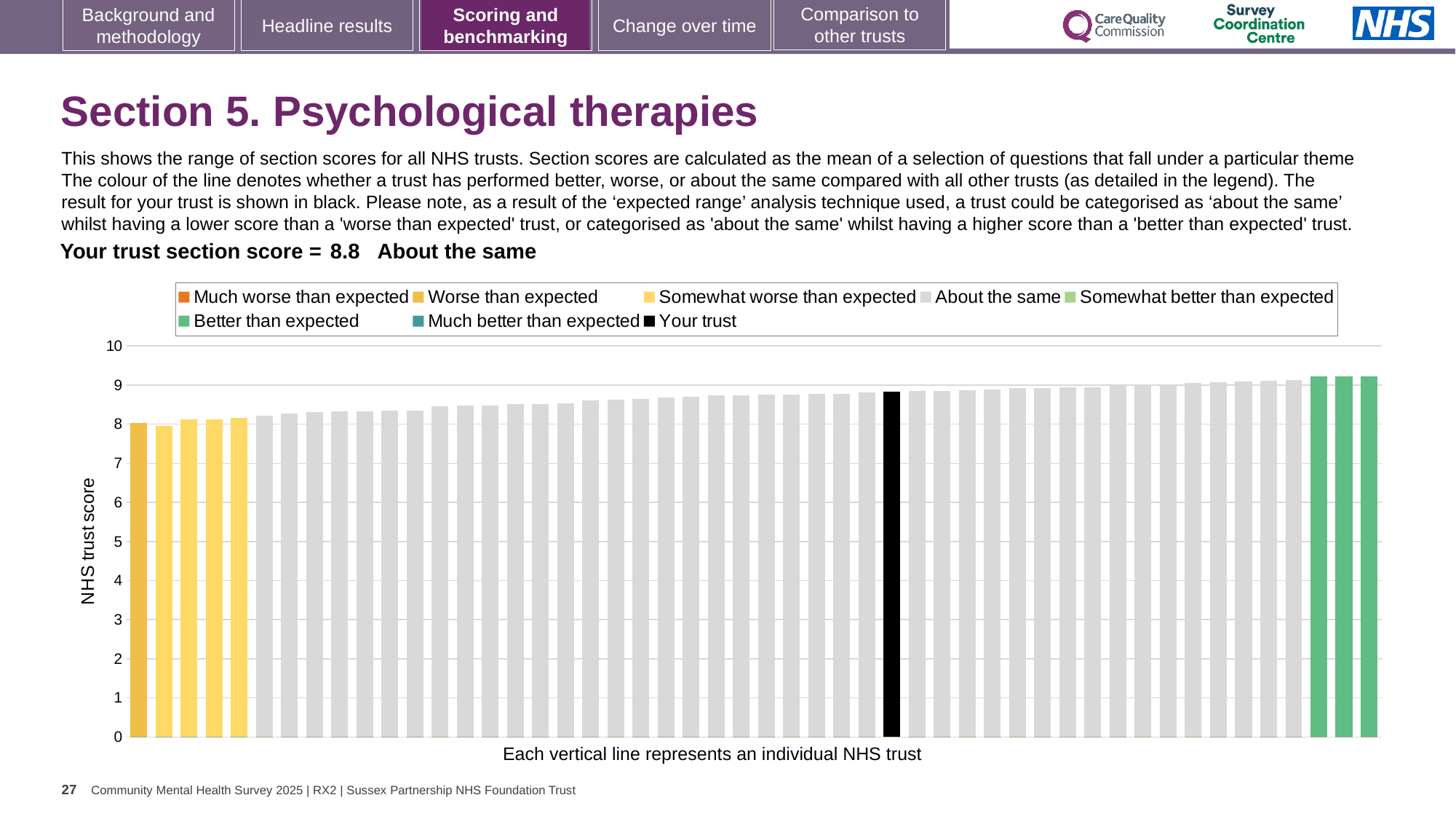
What kind of chart is shown on the slide? bar chart Which category is your trust placed in for this section? About the same How many yellow/orange bars (worse or somewhat worse than expected) are on the chart? 5 What does the black bar on the chart represent? Your trust How many green bars (better than expected) are on the chart? 3 Do the bar values rise or fall moving from left to right along the x axis? rise Is the value for your trust (the black bar) greater or less than 8? greater What is the label on the vertical axis of the chart? NHS trust score Is the value of the lowest bar on the chart greater or less than 7? greater What is the section score for your trust shown on the slide? 8.8 How many entries does the chart legend list? 8 Is the value of the highest bar on the chart greater or less than 9? greater